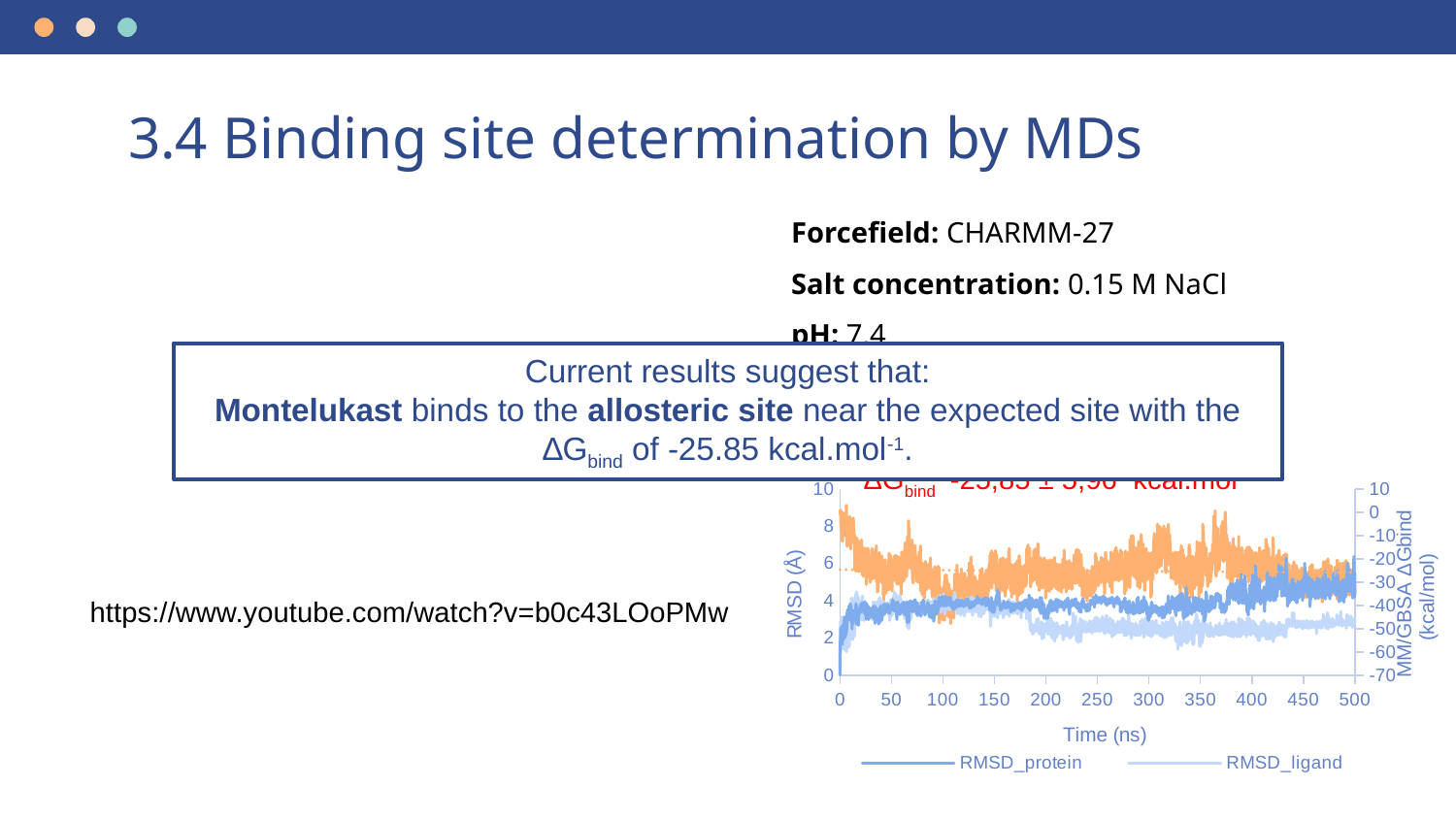
What are the two series named in the chart's legend? RMSD_protein and RMSD_ligand Is the RMSD_ligand value at 500 ns greater or less than 6 Å? less What is the label of the x axis of the chart? Time (ns) What kind of chart is shown on the slide? line chart How many series does the chart's legend list? 2 What is the lowest value shown on the right y axis of the chart? -70 What is the maximum value shown on the left y axis (RMSD) of the chart? 10 Is the RMSD_protein value at 500 ns greater or less than 2 Å? greater Is the RMSD_protein value at 500 ns greater or less than 8 Å? less What is the maximum value shown on the x axis of the chart? 500